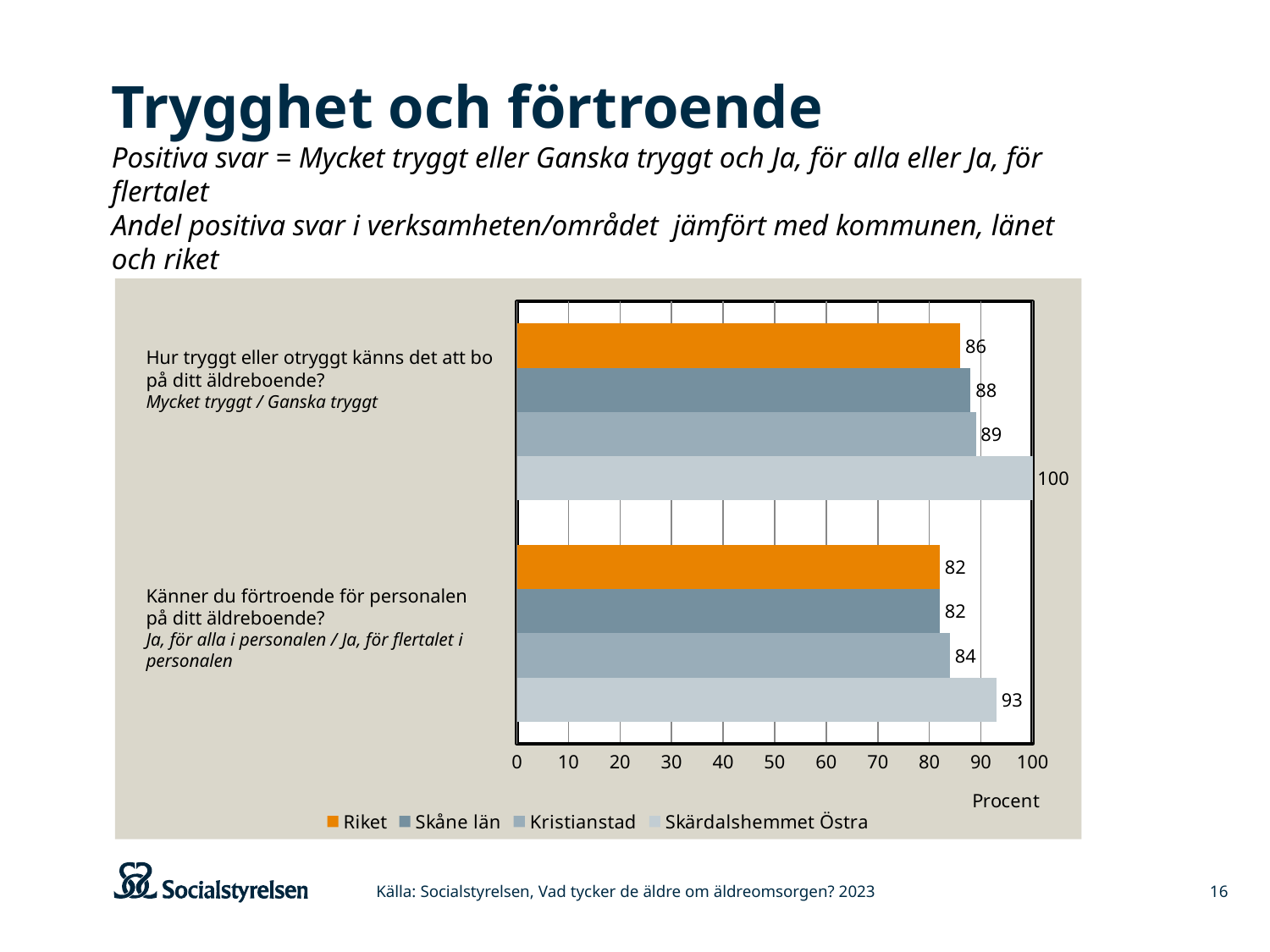
Which is larger for Kristianstad: the value for the trygghet question or the value for the förtroende question? The trygghet question (89) Which series has the lowest value on the question "Hur tryggt eller otryggt känns det att bo på ditt äldreboende?"? Riket How many series does the legend list? 4 What is the value for Kristianstad on the question "Hur tryggt eller otryggt känns det att bo på ditt äldreboende?"? 89 What is the label of the x axis? Procent What is the difference between Skärdalshemmet Östra and Kristianstad on the question "Känner du förtroende för personalen på ditt äldreboende?"? 9 Which series has the highest value on the question "Känner du förtroende för personalen på ditt äldreboende?"? Skärdalshemmet Östra What is the difference between Skärdalshemmet Östra and Riket on the question "Hur tryggt eller otryggt känns det att bo på ditt äldreboende?"? 14 What is the value for Riket on the question "Känner du förtroende för personalen på ditt äldreboende?"? 82 What kind of chart is shown on the slide? Bar chart What is the value for Skärdalshemmet Östra on the question "Hur tryggt eller otryggt känns det att bo på ditt äldreboende?"? 100 What is the value for Skåne län on the question "Känner du förtroende för personalen på ditt äldreboende?"? 82